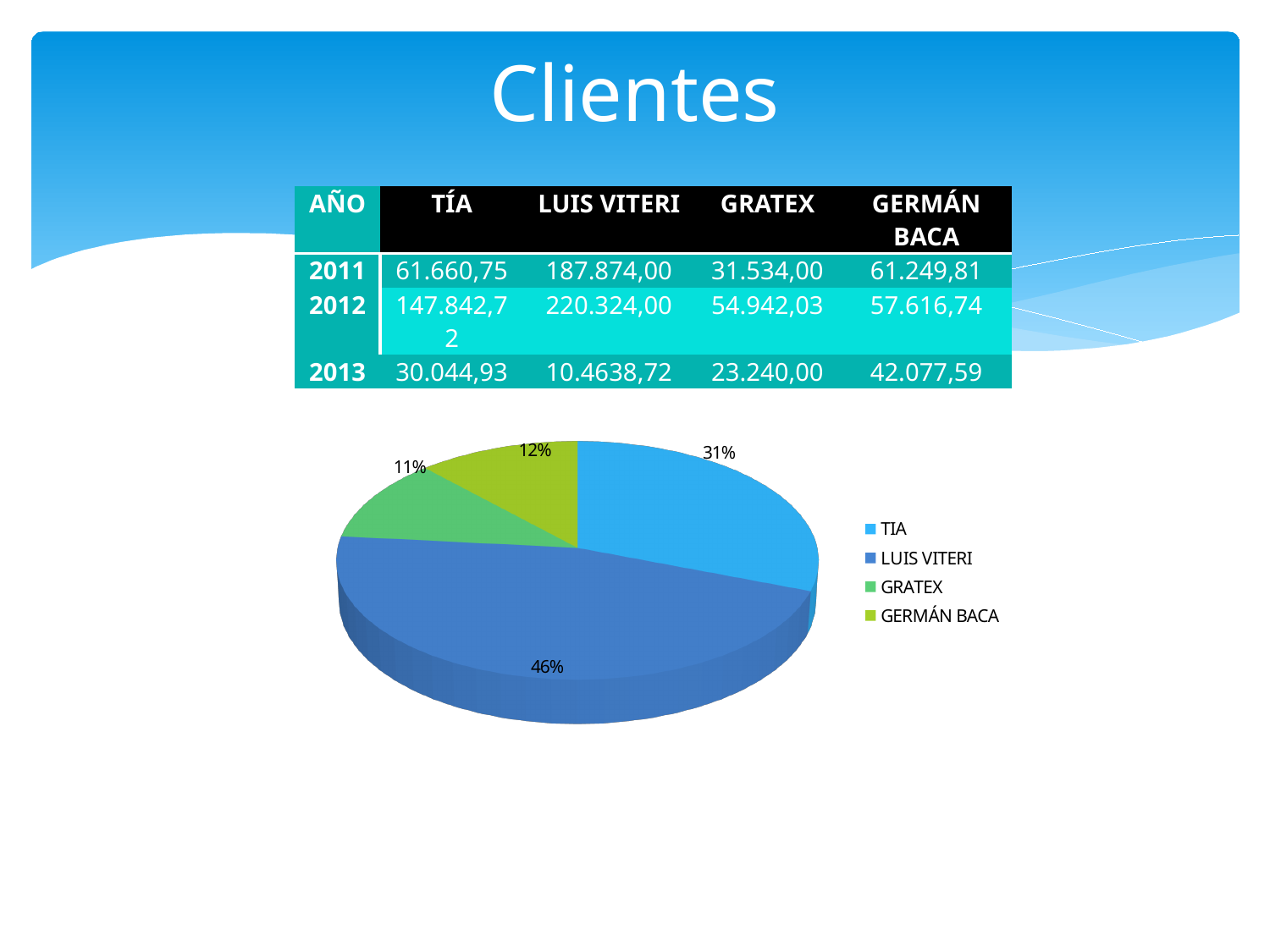
How many entries does the legend of the pie chart list? 4 What colour is the LUIS VITERI slice in the pie chart? Blue What share of the pie does GRATEX hold? 11% What share of the pie does GERMÁN BACA hold? 12% What share of the pie does LUIS VITERI hold? 46% How many slices does the pie chart have? 4 Which client has the smallest slice of the pie? GRATEX What kind of chart is shown on the slide? Pie chart What is the difference in percentage points between the LUIS VITERI slice and the TIA slice? 15 Which slice is larger, TIA or GERMÁN BACA? TIA Which client has the largest slice of the pie? LUIS VITERI